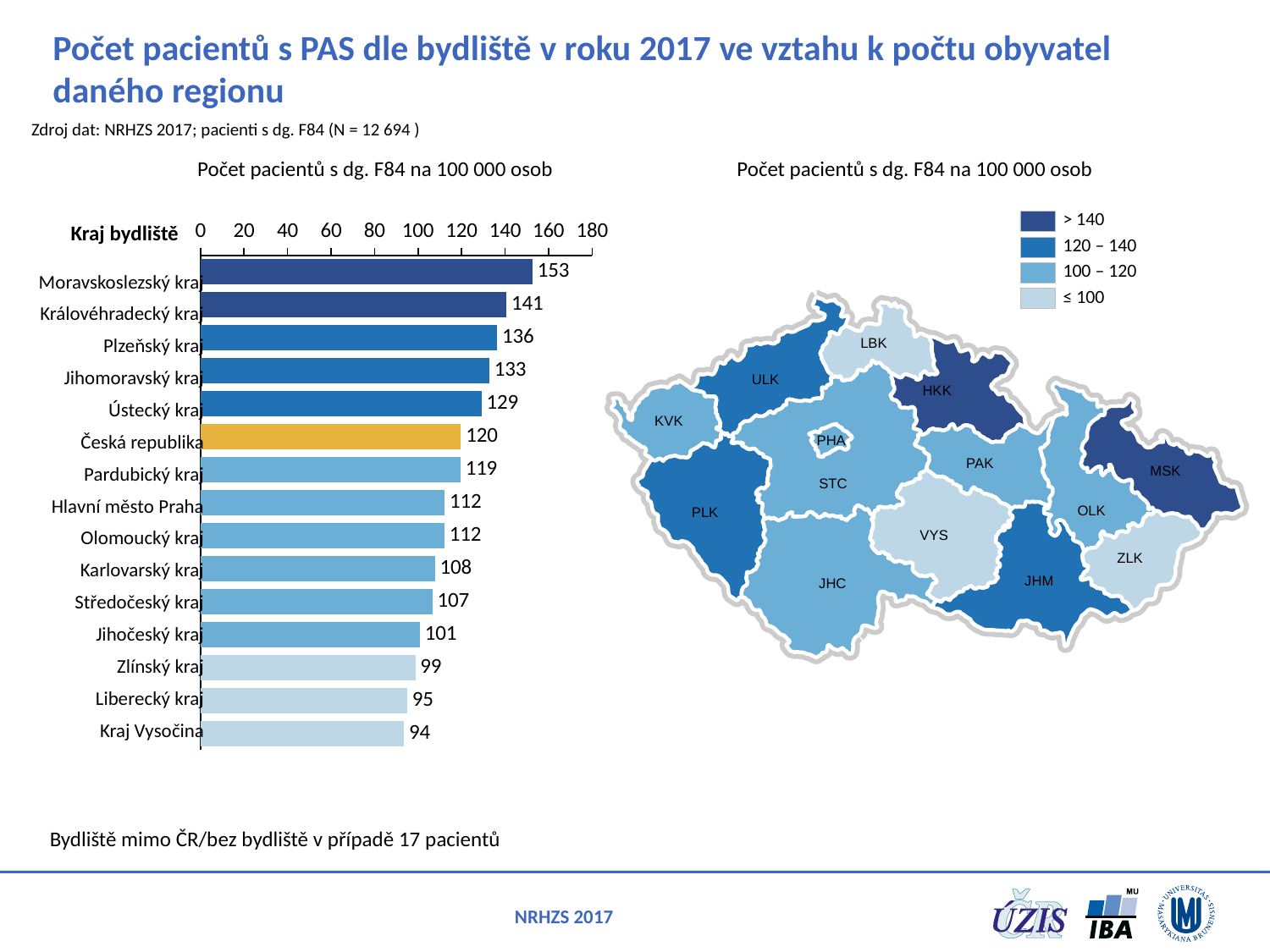
In the bar chart, is the value for Jihomoravský kraj greater or less than 120? greater In the bar chart, which is larger: Ústecký kraj or Pardubický kraj? Ústecký kraj In the bar chart, what is the difference between Moravskoslezský kraj and Kraj Vysočina? 59 In the bar chart, which region has the lowest value? Kraj Vysočina In the bar chart, what is the value for Moravskoslezský kraj? 153 How many categories does the legend of the map on the right list? 4 In the bar chart, what is the value for Liberecký kraj? 95 What type of chart is shown on the left side of the slide? bar chart In the bar chart, which region has the highest value? Moravskoslezský kraj In the bar chart, what is the difference between Královéhradecký kraj and Plzeňský kraj? 5 In the bar chart, what is the value for Česká republika? 120 How many bars does the bar chart show? 15